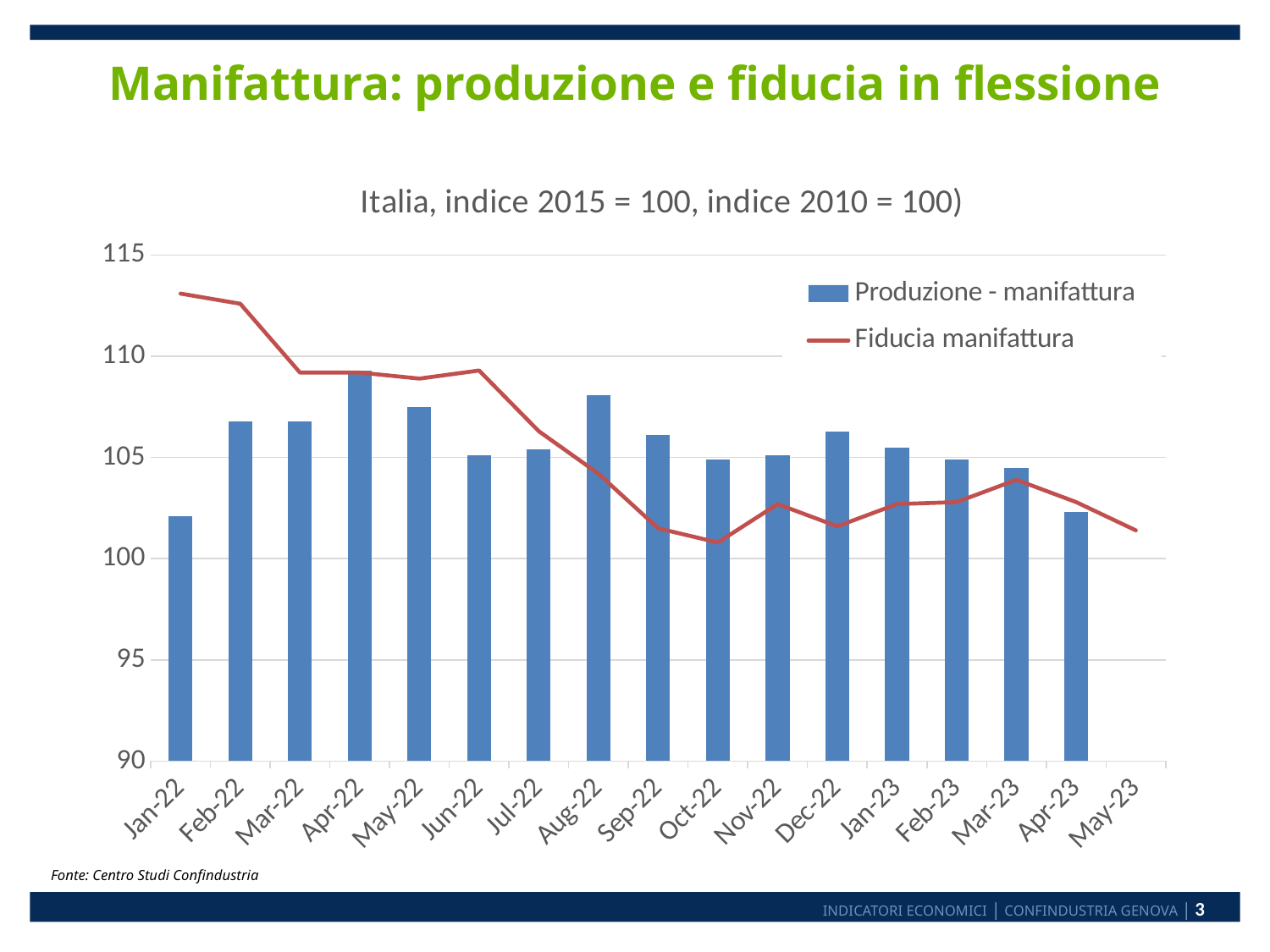
How many series does the legend list? 2 In which month does the Fiducia manifattura line reach its lowest value? Oct-22 In which month does the Fiducia manifattura line reach its highest value? Jan-22 Is the Produzione - manifattura value for Apr-22 greater or less than 110? less Is the Fiducia manifattura value for Oct-22 greater or less than 105? less Which is higher, the Produzione - manifattura bar for Aug-22 or for Sep-22? Aug-22 What is the source cited below the chart? Centro Studi Confindustria Which month has the highest bar for Produzione - manifattura? Apr-22 How many months are shown on the x axis? 17 Does the Fiducia manifattura line rise or fall from Jan-22 to Oct-22? It falls What kind of chart is shown on the slide? A combination of a bar chart and a line chart Is the Fiducia manifattura value for Jan-22 greater or less than 110? greater